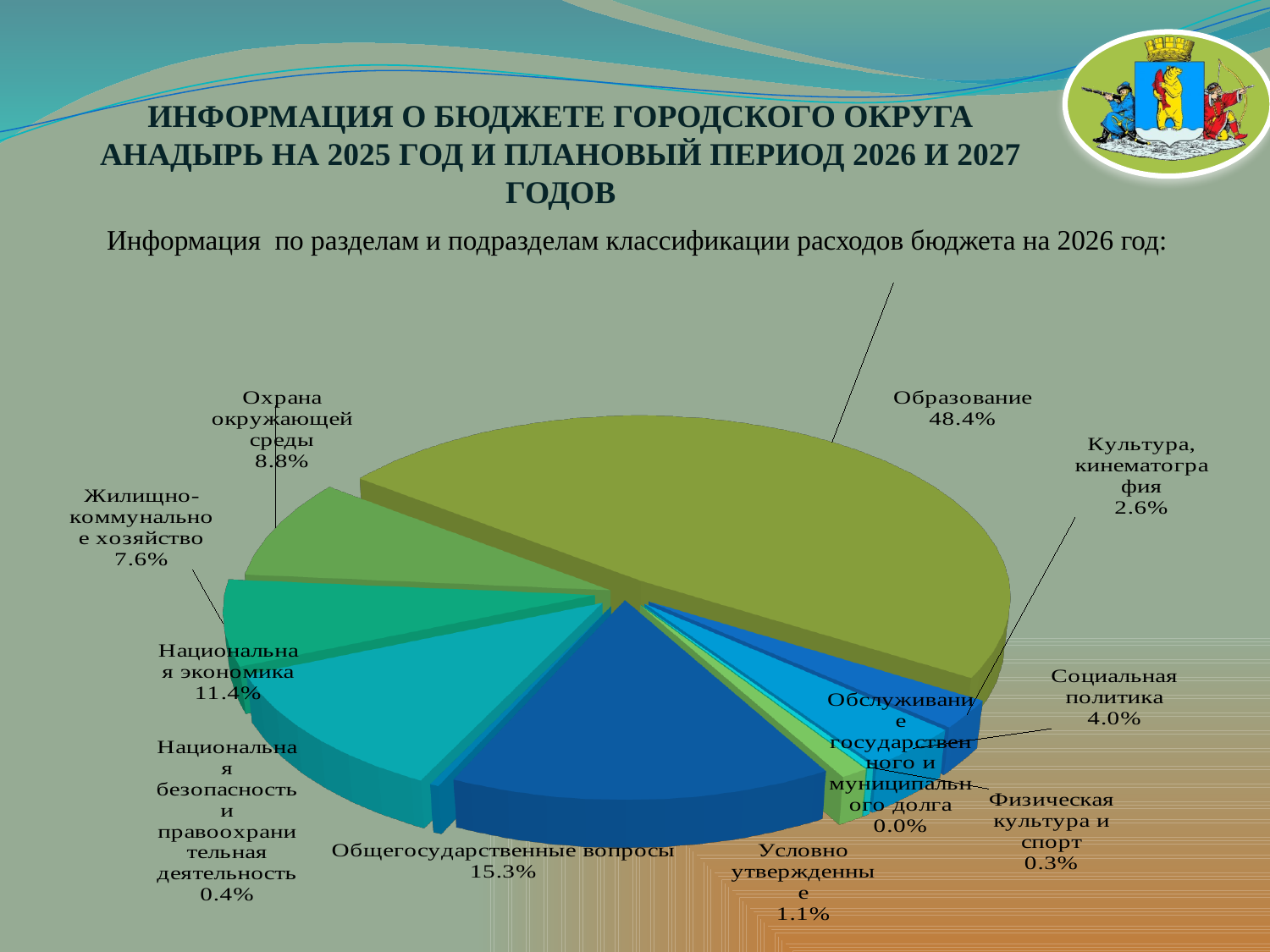
Which category has the largest share of the pie? Образование What share is shown for Жилищно-коммунальное хозяйство? 7.6% What share is shown for Обслуживание государственного и муниципального долга? 0.0% What share is shown for Общегосударственные вопросы? 15.3% What is the difference between the shares of Образование and Общегосударственные вопросы? 33.1% How many categories are shown in the pie chart? 11 Which has a larger share: Охрана окружающей среды or Жилищно-коммунальное хозяйство? Охрана окружающей среды What kind of chart is shown on the slide? pie chart What share is shown for Национальная экономика? 11.4% What share of the 2026 budget expenditures goes to Образование? 48.4% Which category has the smallest share of the pie? Обслуживание государственного и муниципального долга Which year's budget expenditure classification does the chart describe? 2026